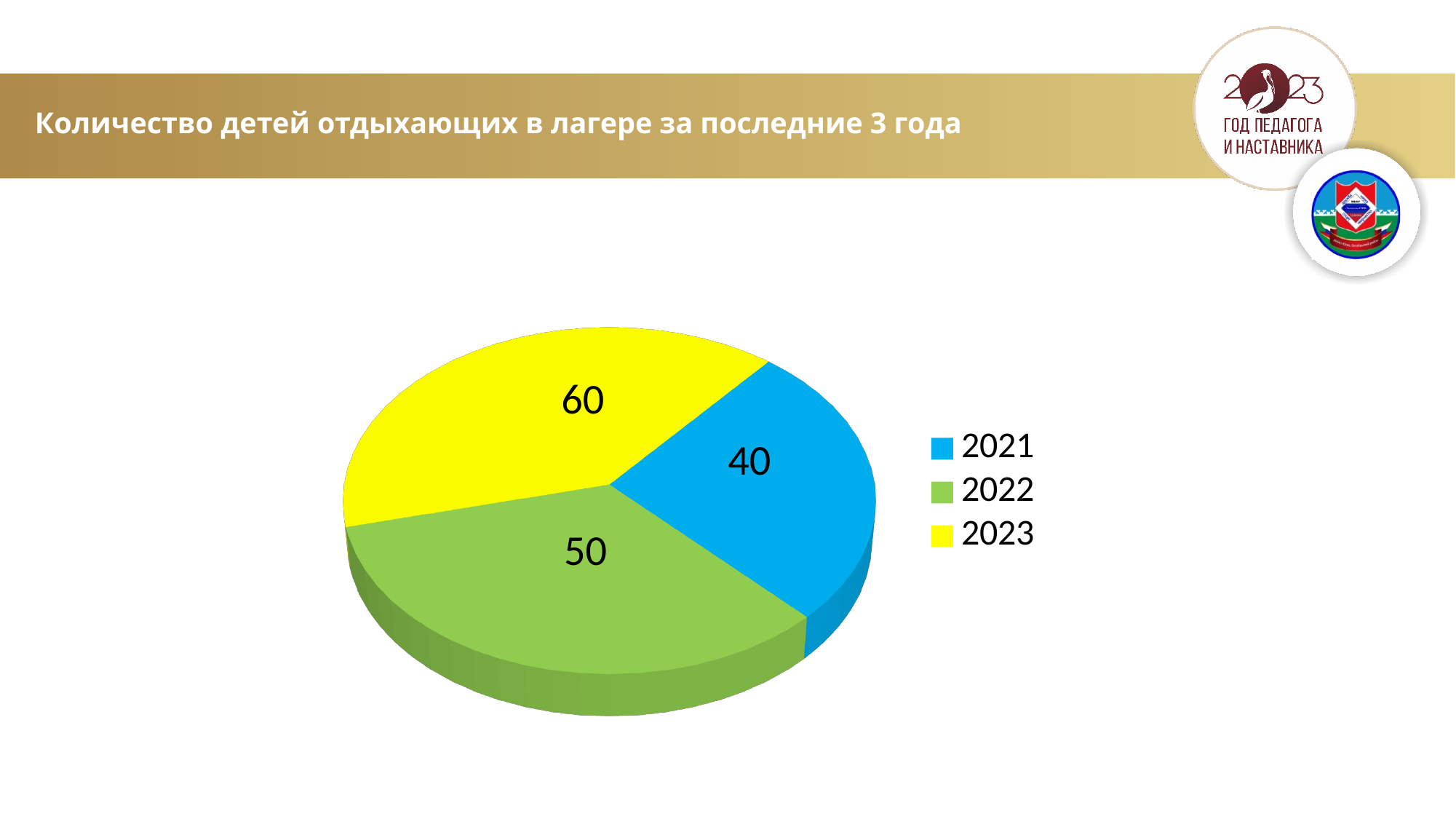
What is the value for 2023 in the pie chart? 60 What is the value for 2021 in the pie chart? 40 Which is larger, the value for 2022 or the value for 2023? 2023 What is the value for 2022 in the pie chart? 50 What is the difference between the values for 2023 and 2021? 20 Which year has the smallest slice in the pie chart? 2021 What type of chart is shown on the slide? pie chart What is the difference between the values for 2022 and 2021? 10 Which year has the largest slice in the pie chart? 2023 What colour is the slice for 2023 in the pie chart? yellow How many slices does the pie chart have? 3 What share of the pie does the 2021 slice represent? 26.7%